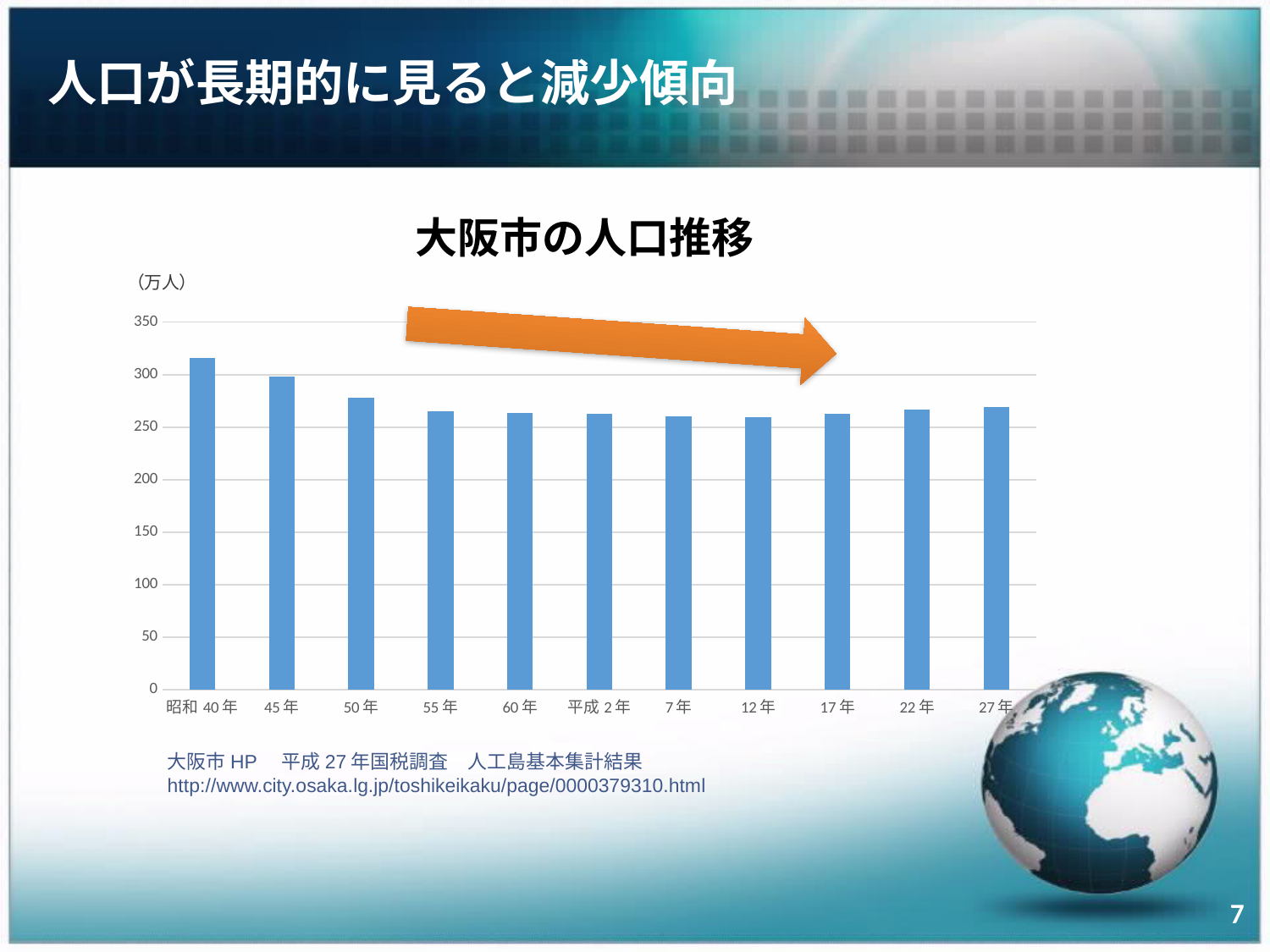
Do the values generally rise or fall from 昭和40年 to 平成7年? fall Is the value for 50年 greater or less than 300? less How many categories (years) are plotted on the x axis? 11 Which is larger, the value for 50年 or the value for 55年? 50年 Is the value for 55年 greater or less than 250? greater Which is larger, the value for 昭和40年 or the value for 27年? 昭和40年 Is the value for 昭和40年 greater or less than 300? greater What is the title of the chart? 大阪市の人口推移 What type of chart is shown on the slide? bar chart Which year has the highest population bar? 昭和40年